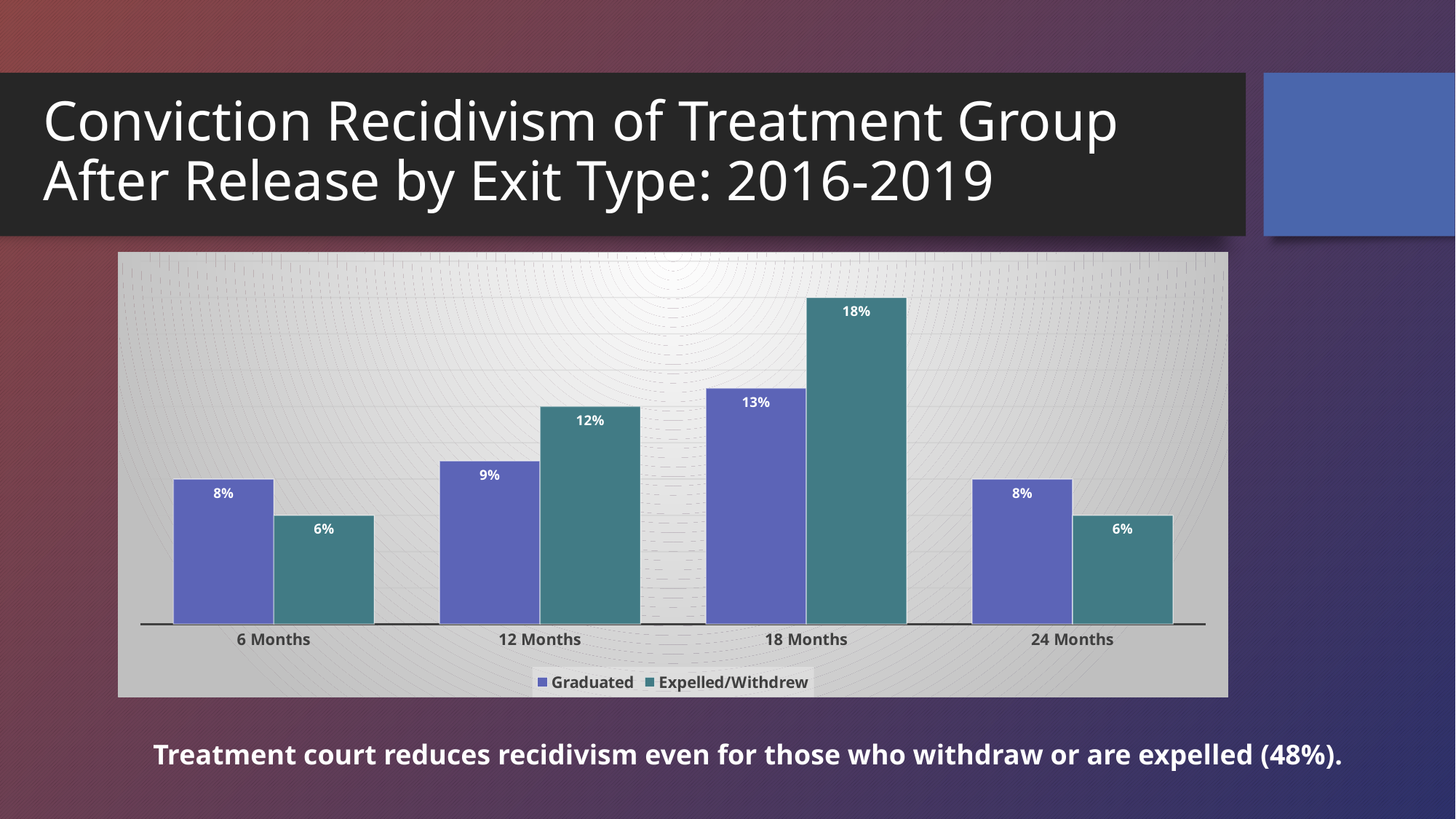
What is the value for Graduated at 18 Months? 13% What kind of chart is shown on the slide? Bar chart At which time point is the Expelled/Withdrew value highest? 18 Months How many series does the legend list? 2 What is the value for Graduated at 6 Months? 8% What is the value for Expelled/Withdrew at 24 Months? 6% Which is larger at 6 Months, Graduated or Expelled/Withdrew? Graduated What is the difference between the Expelled/Withdrew and Graduated values at 18 Months? 5% How many time-point categories are shown on the x axis? 4 Which is larger at 12 Months, Graduated or Expelled/Withdrew? Expelled/Withdrew What is the value for Expelled/Withdrew at 12 Months? 12% At which time point is the Graduated value highest? 18 Months